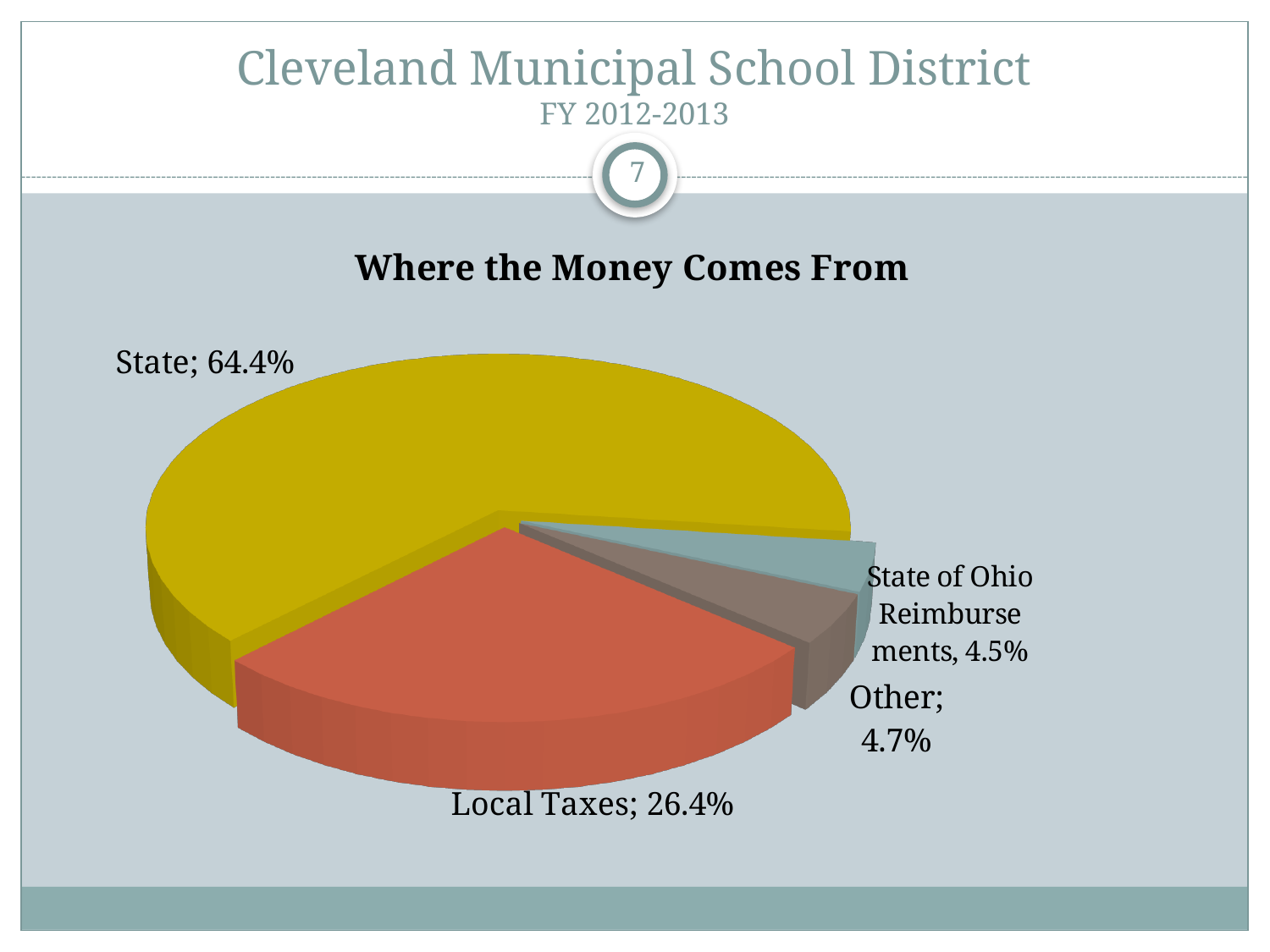
What is the title of the chart? Where the Money Comes From Which category has the largest slice of the pie? State What is the difference in percentage points between State and Local Taxes? 38.0 percentage points What share of the pie does Local Taxes account for? 26.4% What share of the pie does Other account for? 4.7% How many slices does the pie chart have? 4 Which category has the smallest slice of the pie? State of Ohio Reimbursements What colour is the State slice of the pie? Yellow What kind of chart is shown on the slide? Pie chart Which is larger, the share for Local Taxes or the share for Other? Local Taxes What share of the pie does State of Ohio Reimbursements account for? 4.5% What share of the pie does State account for? 64.4%